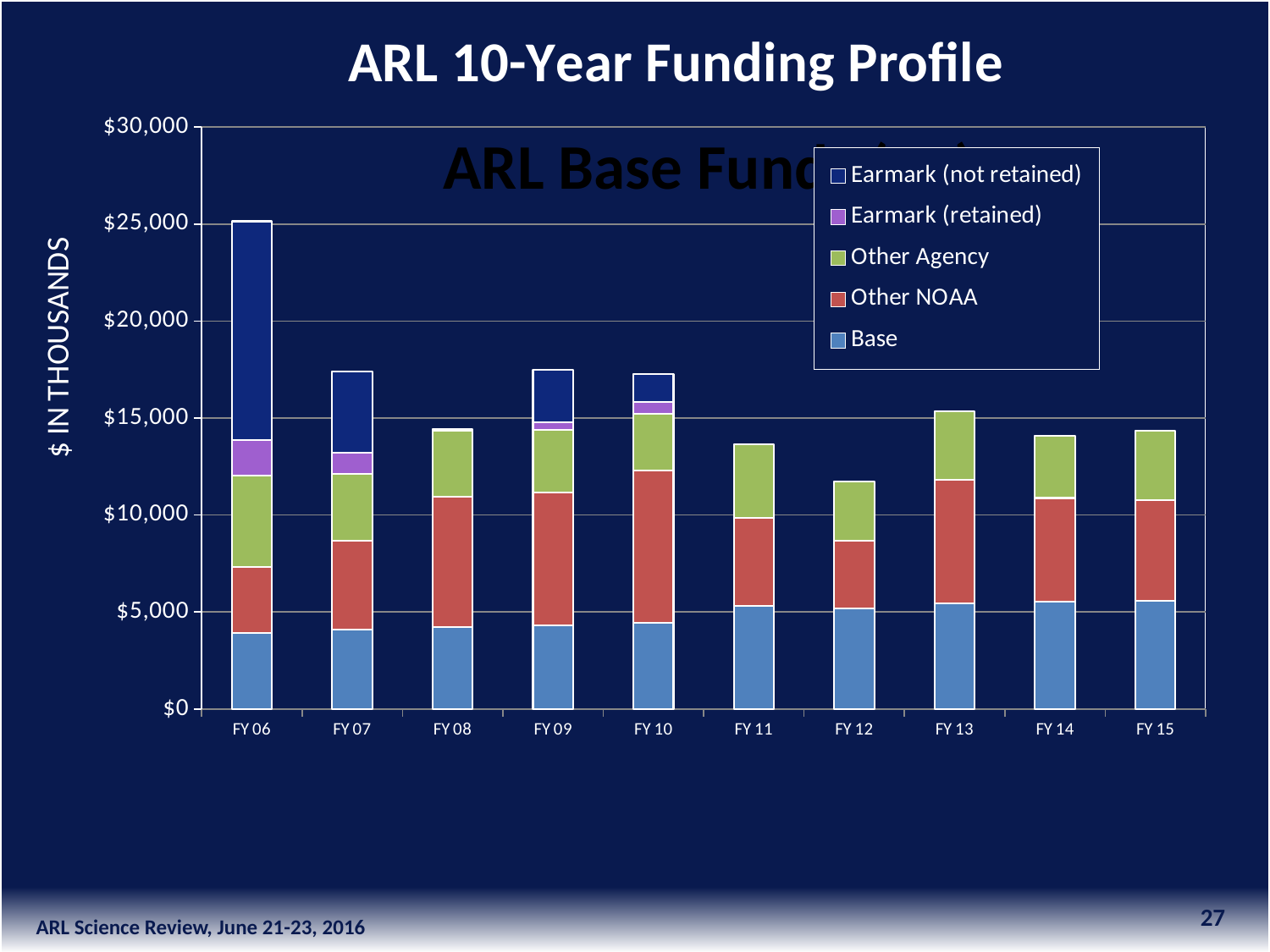
Is the total funding bar for FY 06 greater or less than $20,000? greater Is the Base segment for FY 06 greater or less than $5,000? less How many fiscal years are shown on the x axis of the chart? 10 Which total funding bar is taller, FY 06 or FY 07? FY 06 Which fiscal year has the highest total funding bar? FY 06 Is the total funding bar for FY 11 greater or less than $15,000? less How many series does the chart's legend list? 5 Which legend series is shown in the bottom segment of each bar? Base What kind of chart is shown on the slide? Stacked bar chart What is the label on the y axis of the chart? $ IN THOUSANDS Which fiscal year has the lowest total funding bar? FY 12